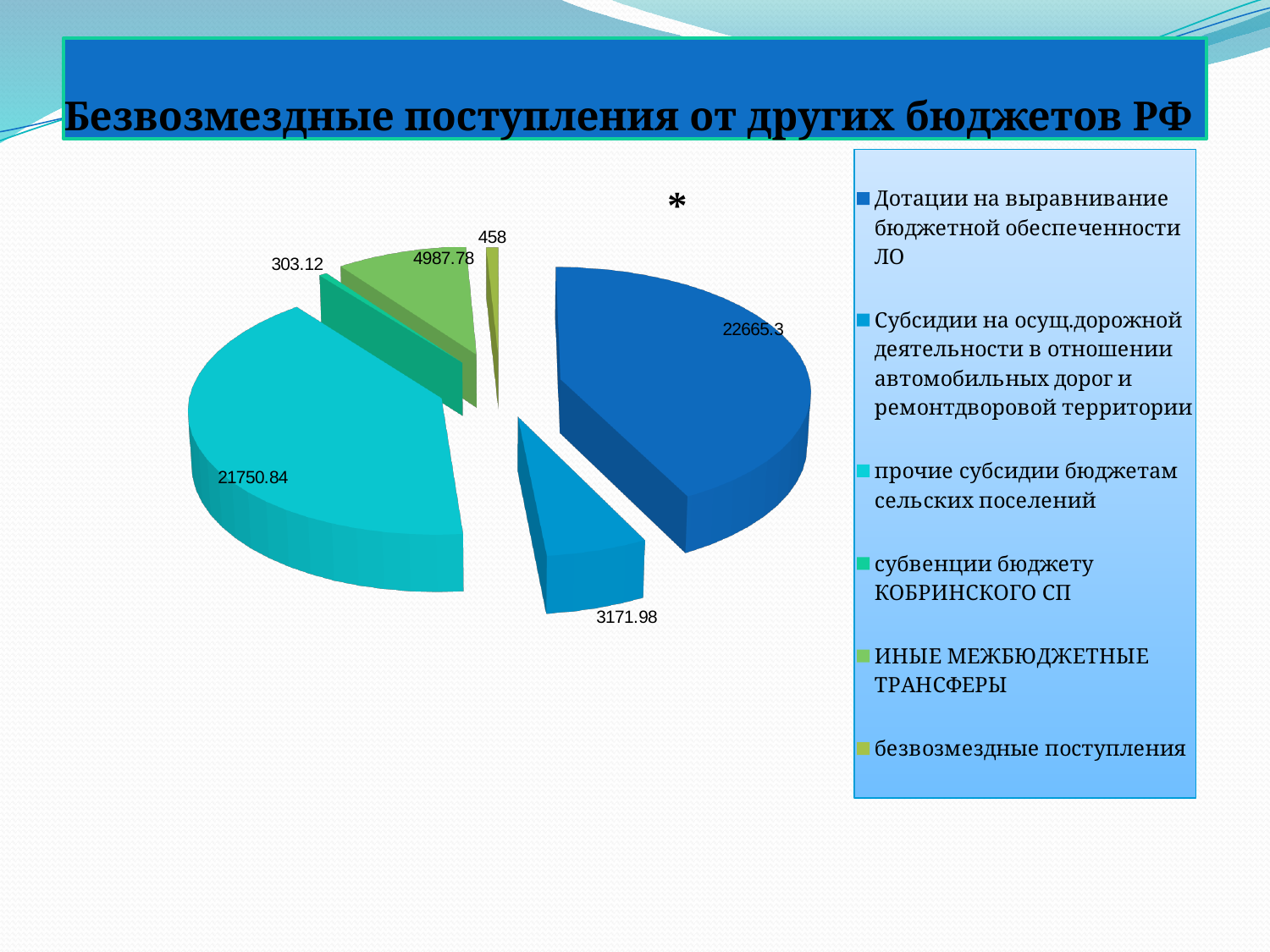
What is the value for безвозмездные поступления? 458 What is the title of the slide? Безвозмездные поступления от других бюджетов РФ What is the value for прочие субсидии бюджетам сельских поселений? 21750.84 What kind of chart is shown on the slide? pie chart What is the value for Дотации на выравнивание бюджетной обеспеченности ЛО? 22665.3 What is the difference between the values for Дотации на выравнивание бюджетной обеспеченности ЛО and прочие субсидии бюджетам сельских поселений? 914.46 Which is larger: the value for ИНЫЕ МЕЖБЮДЖЕТНЫЕ ТРАНСФЕРЫ or the value for Субсидии на осущ.дорожной деятельности? ИНЫЕ МЕЖБЮДЖЕТНЫЕ ТРАНСФЕРЫ What is the value for ИНЫЕ МЕЖБЮДЖЕТНЫЕ ТРАНСФЕРЫ? 4987.78 Which category has the largest slice of the pie? Дотации на выравнивание бюджетной обеспеченности ЛО What is the value for субвенции бюджету КОБРИНСКОГО СП? 303.12 How many slices does the pie chart have? 6 Which category has the smallest slice of the pie? субвенции бюджету КОБРИНСКОГО СП